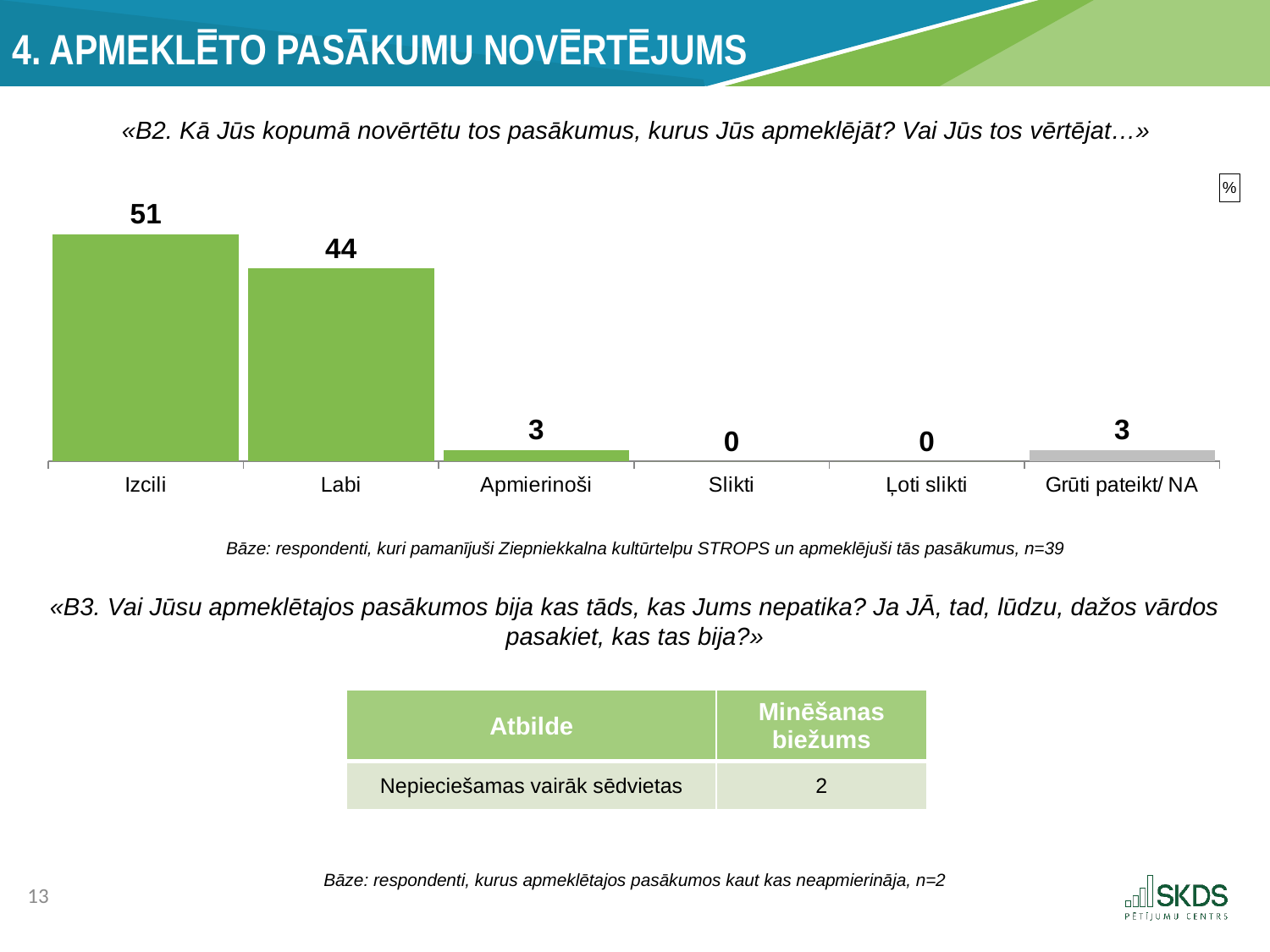
Which is larger, the value for Labi or the value for Apmierinoši? Labi What kind of chart is shown on the slide? bar chart What is the value for Apmierinoši? 3 What is the value for Slikti? 0 What is the value for Grūti pateikt/ NA? 3 What is the value for Izcili? 51 What unit is indicated in the top right corner of the chart? % How many categories are shown on the x axis of the chart? 6 Which category has the highest value? Izcili What is the value for Labi? 44 What is the difference between the values for Izcili and Labi? 7 What is the combined value of Izcili and Labi? 95